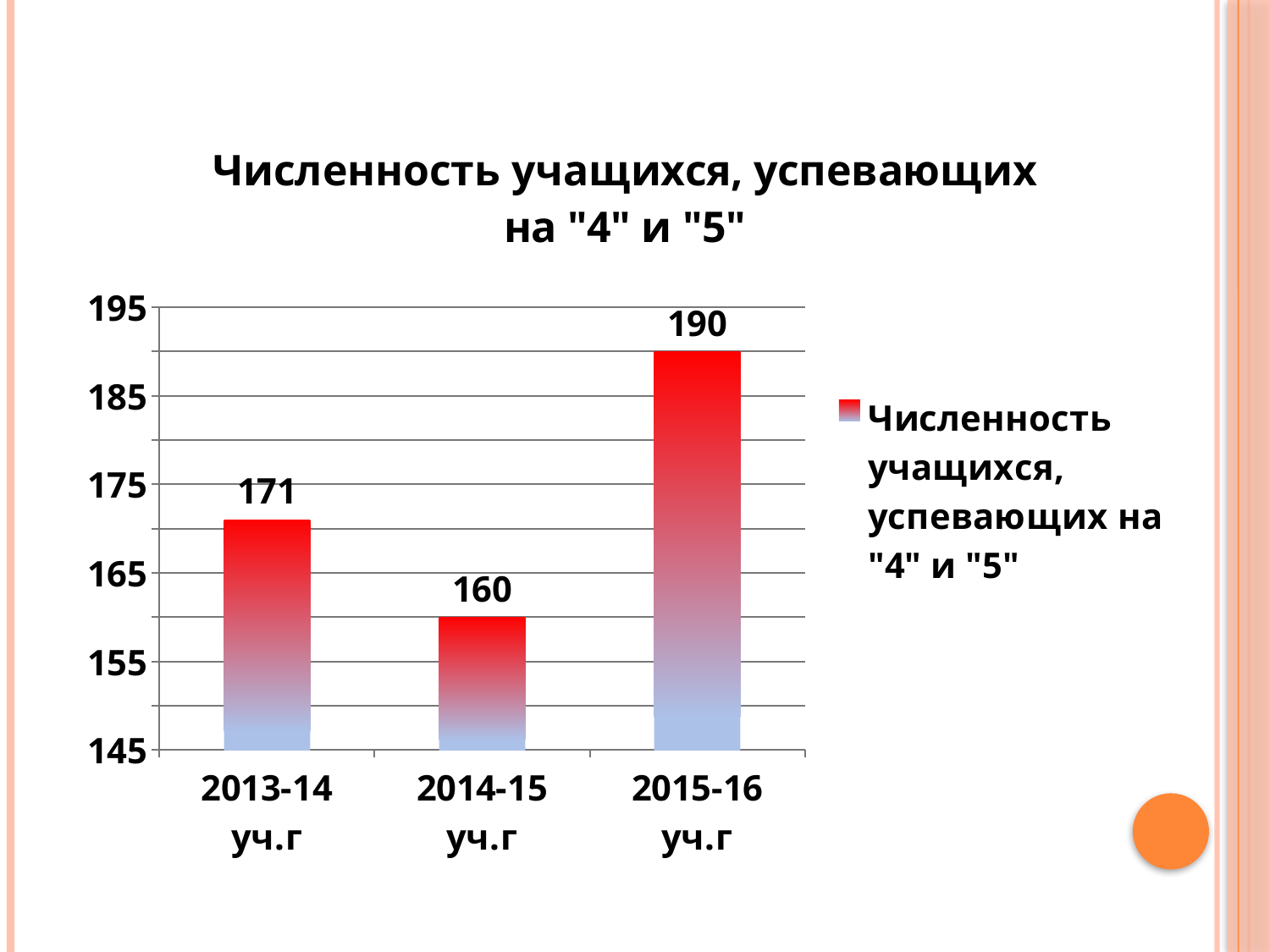
What kind of chart is shown on the slide? bar chart Is the value for 2015-16 уч.г greater or less than 185? greater How many academic years are shown on the chart? 3 Which is larger, the value for 2013-14 уч.г or 2014-15 уч.г? 2013-14 уч.г What is the value for 2015-16 уч.г? 190 What is the difference between the values for 2013-14 уч.г and 2014-15 уч.г? 11 What is the difference between the values for 2015-16 уч.г and 2014-15 уч.г? 30 Which academic year has the highest value? 2015-16 уч.г Which academic year has the lowest value? 2014-15 уч.г What is the value for 2013-14 уч.г? 171 What is the value for 2014-15 уч.г? 160 What is the title of the chart? Численность учащихся, успевающих на "4" и "5"